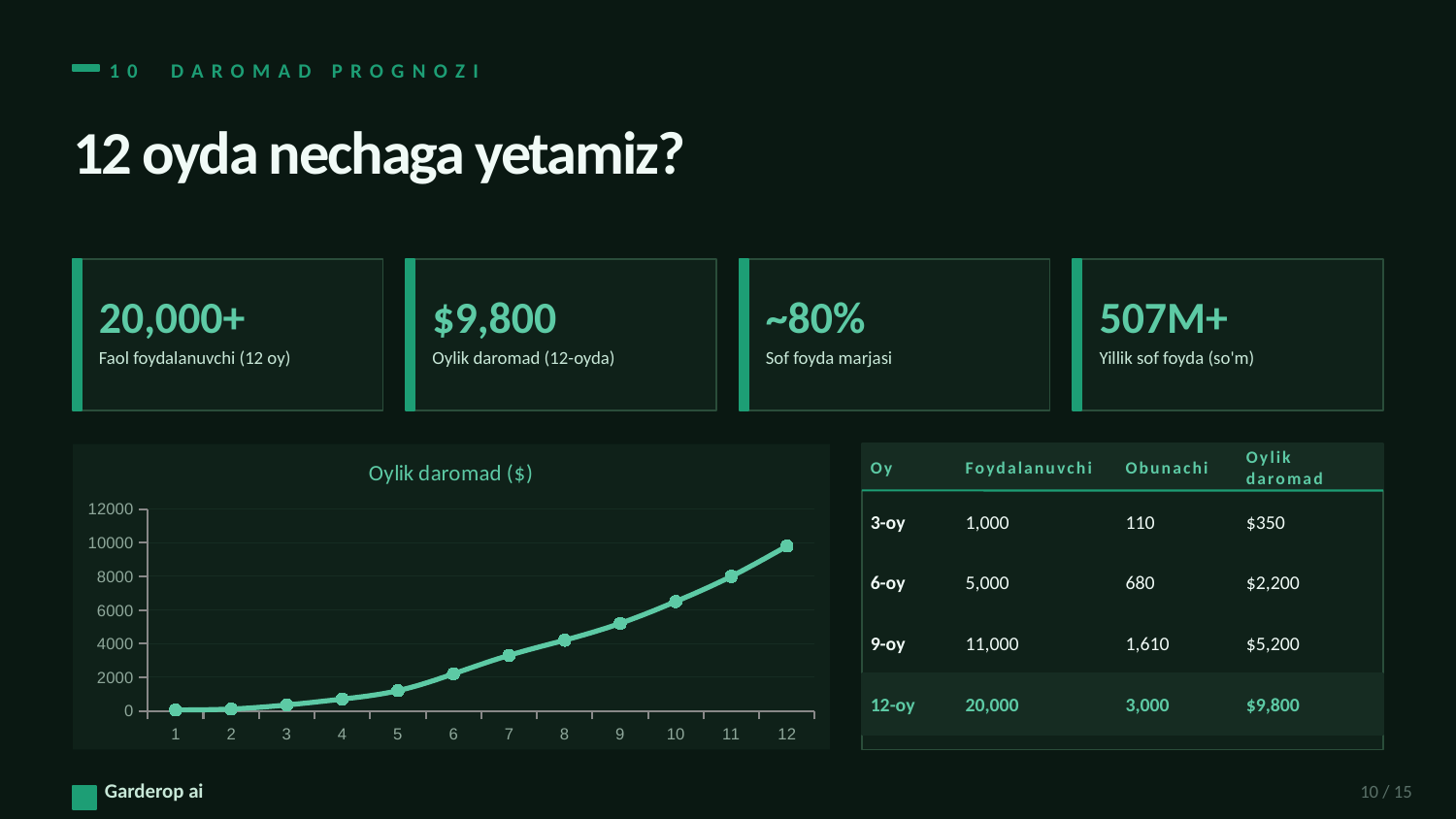
Is the value for month 12 greater or less than 8000? greater What is the title of the chart? Oylik daromad ($) Which month has the highest value on the chart? 12 Is the value for month 9 greater or less than 4000? greater Do the values on the chart rise or fall from month 1 to month 12? rise Is the value for month 7 greater or less than 4000? less How many data points are plotted on the line chart? 12 Which is larger on the chart, the value for month 6 or the value for month 12? month 12 What is the highest tick value shown on the y axis of the chart? 12000 What kind of chart is shown on the slide? line chart